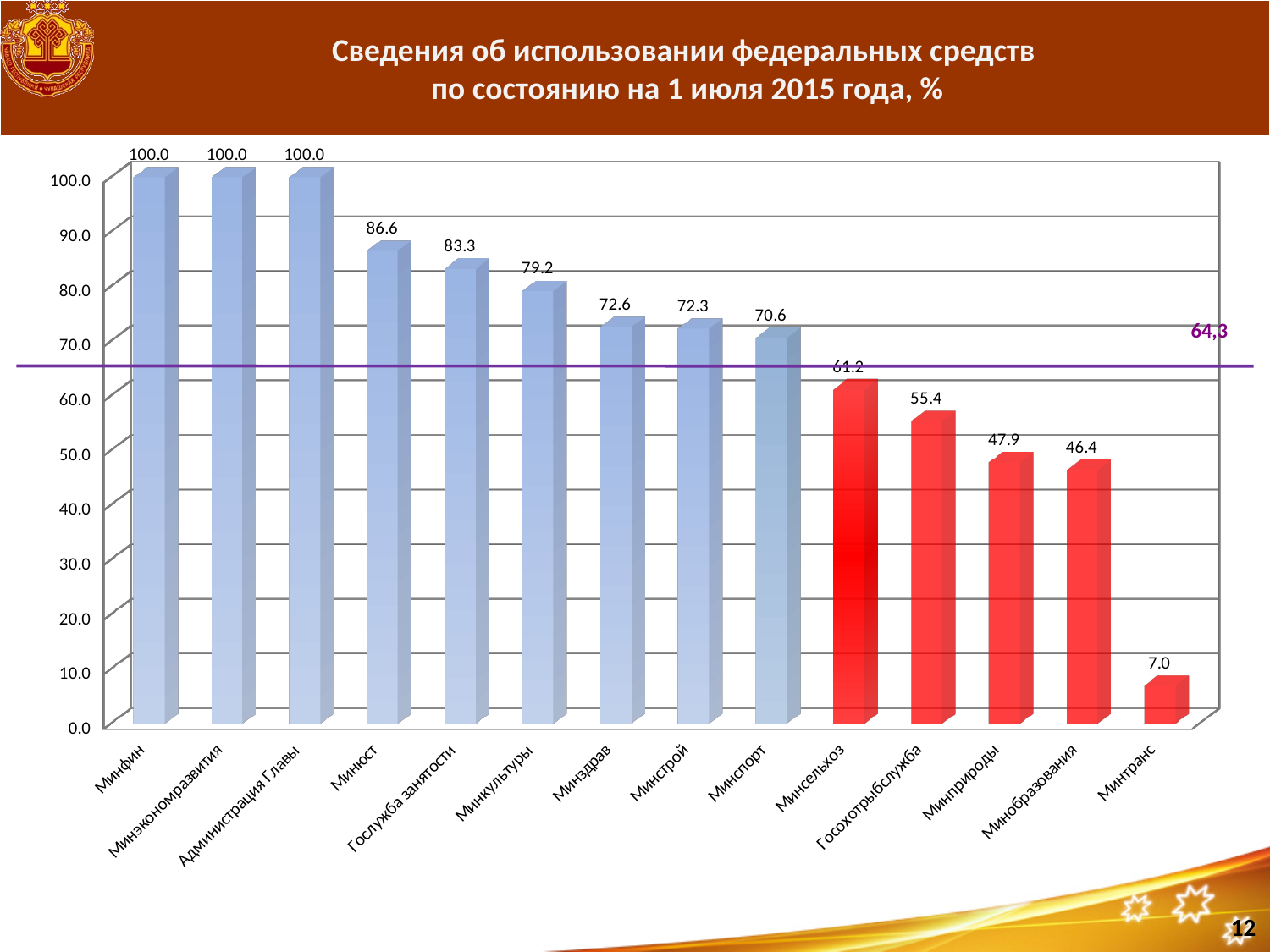
What kind of chart is shown on the slide? bar chart How many categories have a value of 100.0? 3 What is the value for Госохотрыбслужба? 55.4 What value is labelled on the horizontal line drawn across the chart? 64,3 How many categories are shown on the x axis? 14 What is the difference between the values for Минкультуры and Минздрав? 6.6 What is the value for Минюст? 86.6 Do the values rise or fall from left to right along the x axis? fall Which is larger, the value for Минприроды or the value for Минобразования? Минприроды What is the value for Минтранс? 7.0 Which category has the lowest value? Минтранс Is the value for Минсельхоз greater or less than 70.0? less